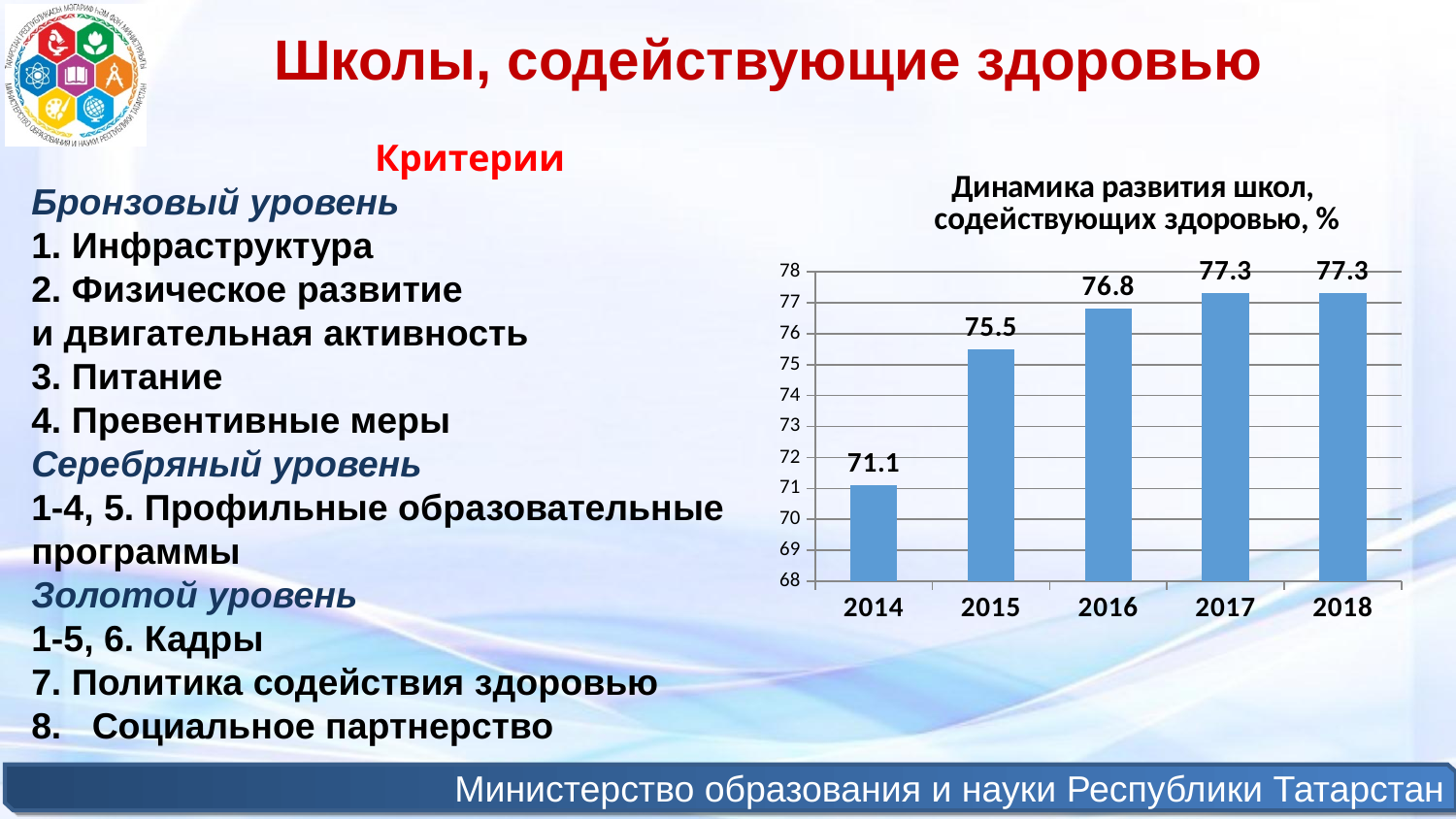
What is the difference between the values for 2017 and 2016? 0.5 What is the title of the chart? Динамика развития школ, содействующих здоровью, % What kind of chart is shown? bar chart What is the value for 2016? 76.8 What is the value for 2014? 71.1 Do the values rise or fall from 2014 to 2018? rise Which is larger, the value for 2015 or the value for 2016? 2016 Is the value for 2015 greater or less than 75? greater How many years are shown on the x axis? 5 Which year has the lowest value? 2014 What is the difference between the values for 2015 and 2014? 4.4 What is the value for 2018? 77.3